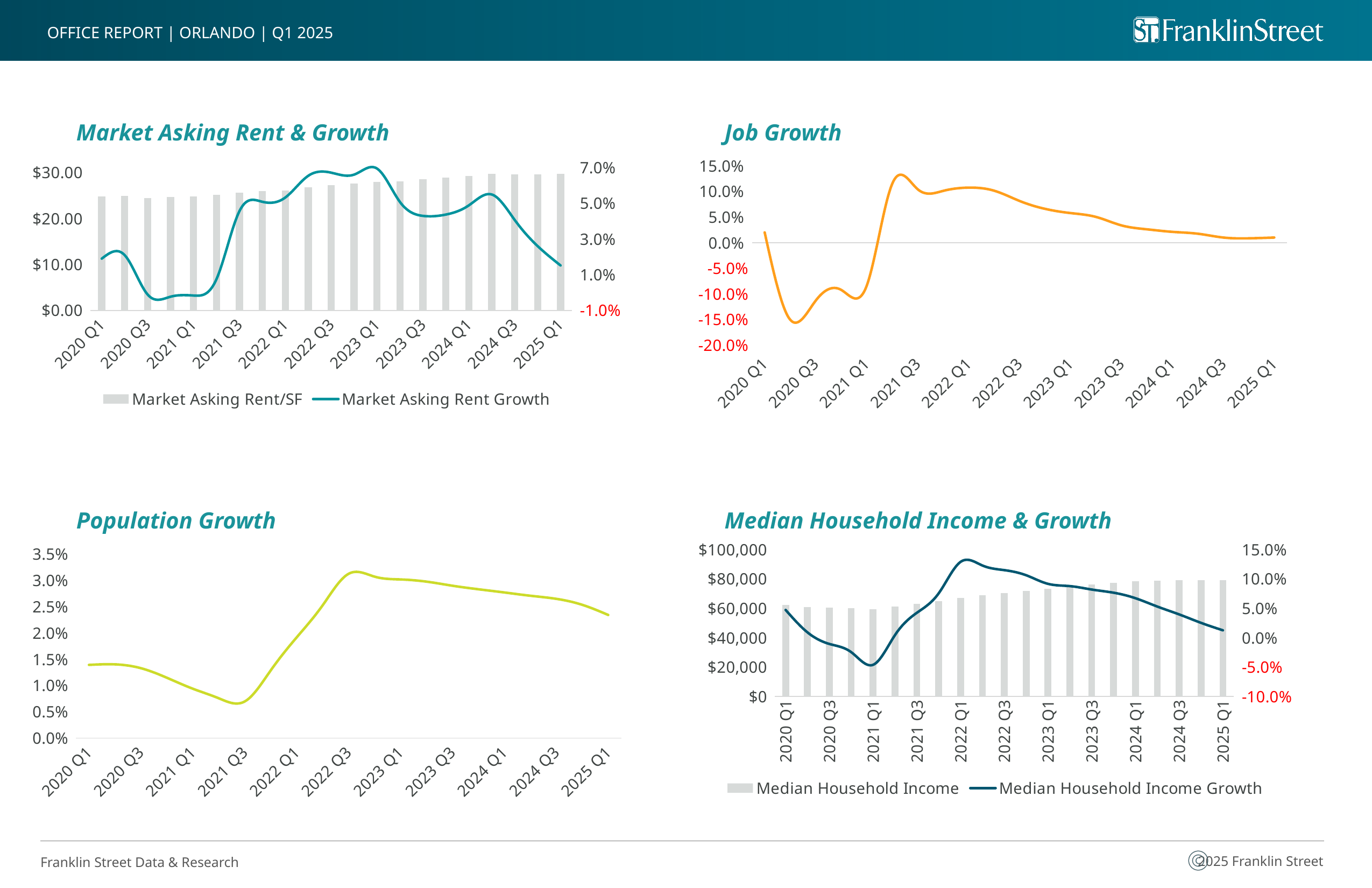
In the Median Household Income & Growth chart, is the Median Household Income Growth value for 2021 Q1 greater or less than 0.0%? less In the Population Growth chart, is the value for 2021 Q3 greater or less than 1.0%? less What colour is the line in the Job Growth chart? orange In the Job Growth chart, is the value for 2020 Q3 greater or less than -10.0%? less In the Job Growth chart, which quarter has the lowest job growth? 2020 Q2 How many series does the legend of the Median Household Income & Growth chart list? 2 In the Population Growth chart, which quarter has the lowest population growth? 2021 Q3 In the Job Growth chart, does job growth rise or fall from 2021 Q3 to 2025 Q1? fall What kind of chart is the Population Growth chart? line chart